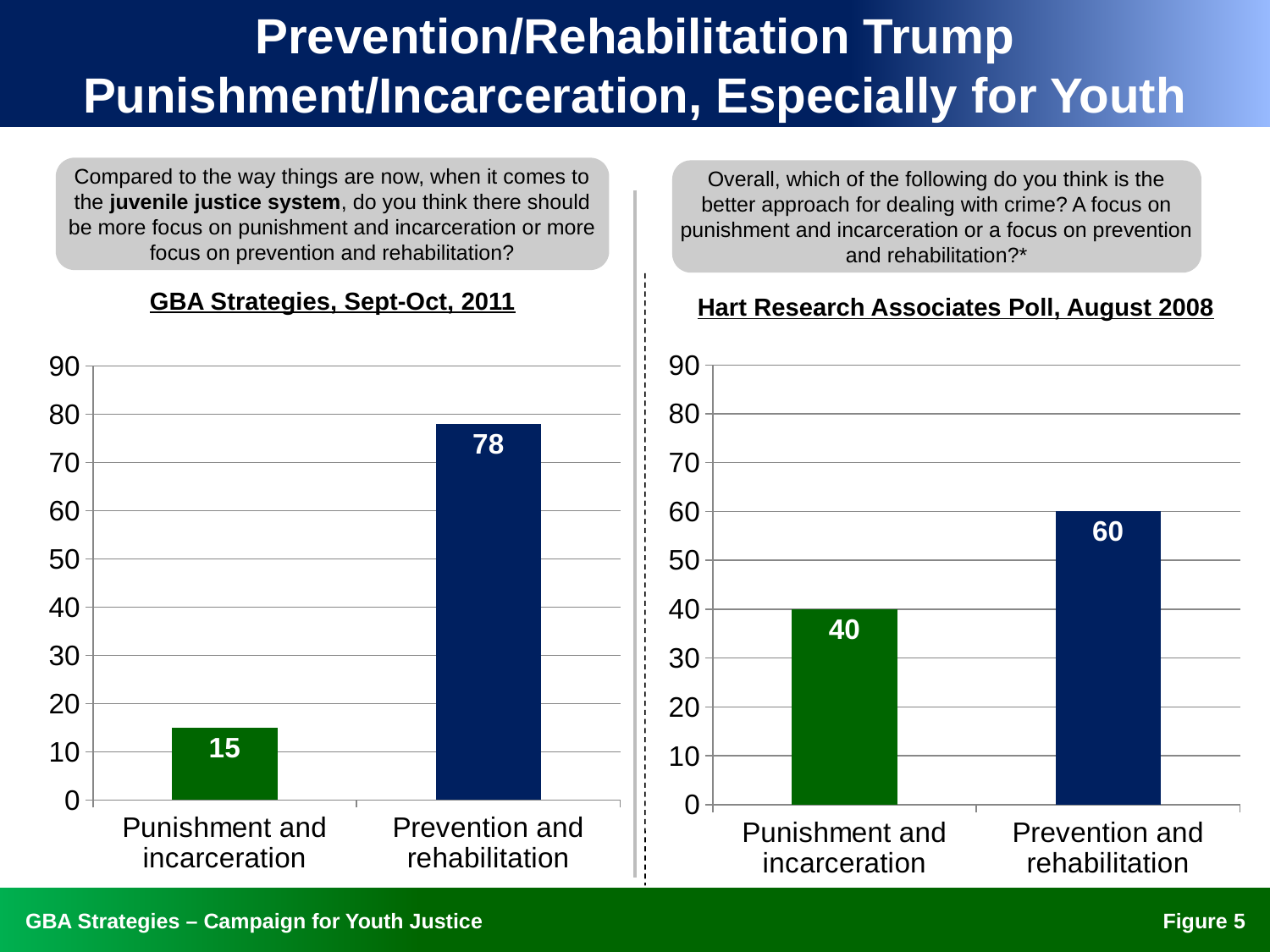
Which is larger: the value for Punishment and incarceration in the GBA Strategies chart or in the Hart Research Associates Poll chart? Hart Research Associates Poll chart What kind of chart is the Hart Research Associates Poll, August 2008 chart? bar chart In the Hart Research Associates Poll, August 2008 chart, what is the value for Punishment and incarceration? 40 In the GBA Strategies, Sept-Oct, 2011 chart, what is the difference between the values for Prevention and rehabilitation and Punishment and incarceration? 63 In the GBA Strategies, Sept-Oct, 2011 chart, which category has the highest value? Prevention and rehabilitation In the Hart Research Associates Poll, August 2008 chart, is the value for Prevention and rehabilitation greater or less than 50? greater How many categories are shown in the GBA Strategies, Sept-Oct, 2011 chart? 2 In the Hart Research Associates Poll, August 2008 chart, what is the difference between the values for Prevention and rehabilitation and Punishment and incarceration? 20 In the Hart Research Associates Poll, August 2008 chart, which category has the lowest value? Punishment and incarceration In the Hart Research Associates Poll, August 2008 chart, what is the value for Prevention and rehabilitation? 60 In the GBA Strategies, Sept-Oct, 2011 chart, what is the value for Prevention and rehabilitation? 78 In the GBA Strategies, Sept-Oct, 2011 chart, what is the value for Punishment and incarceration? 15